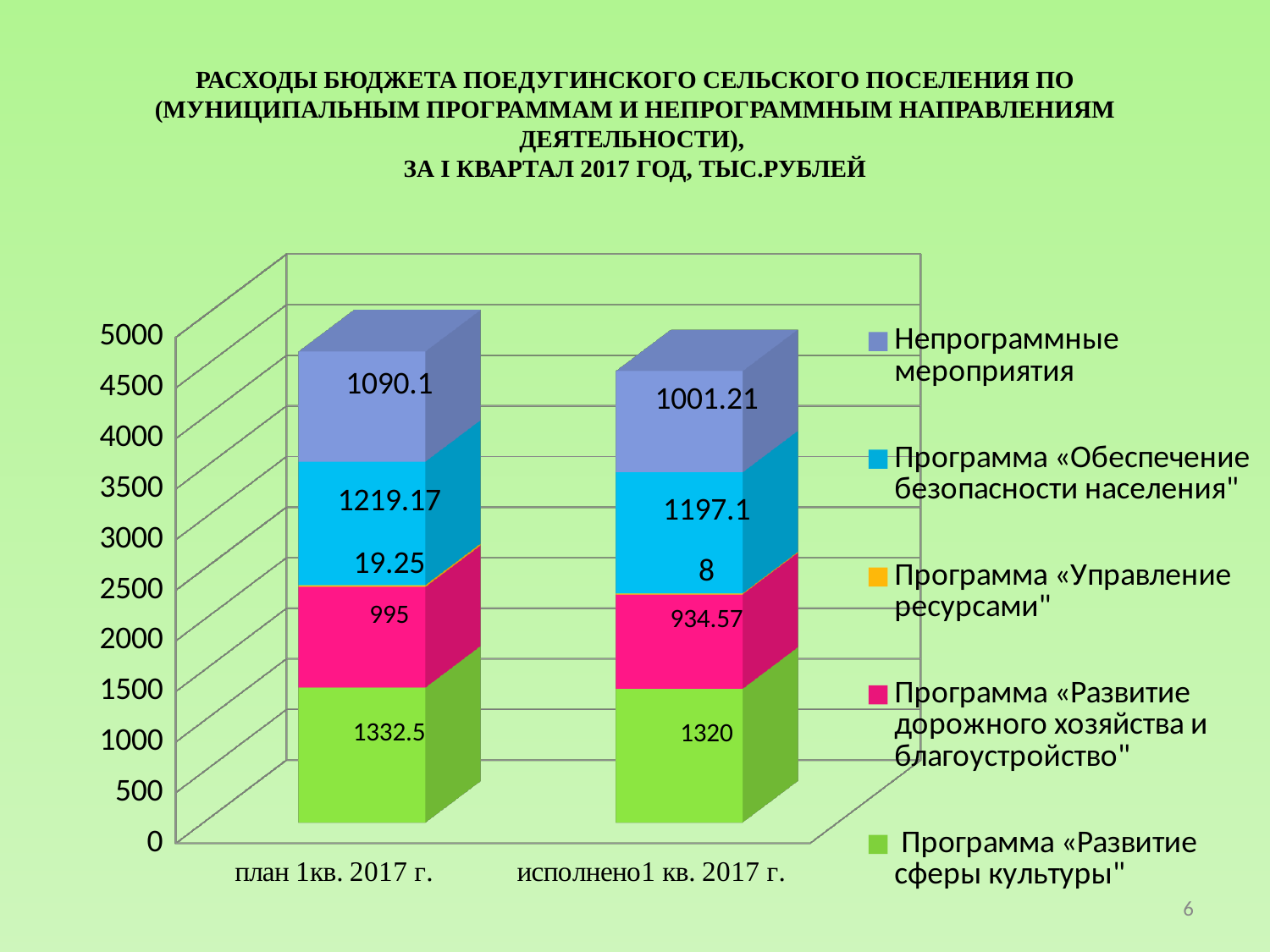
What is the value of «Программа «Управление ресурсами»» for план 1кв. 2017 г.? 19.25 What kind of chart is shown on the slide? Stacked bar chart What is the difference between the план and исполнено values for «Программа «Управление ресурсами»»? 11.25 What is the difference between the план and исполнено values for «Непрограммные мероприятия»? 88.89 How many series does the legend list? 5 What is the value of «Программа «Обеспечение безопасности населения»» for план 1кв. 2017 г.? 1219.17 What is the total of the stacked bar for план 1кв. 2017 г.? 4656.02 What is the value of «Программа «Развитие дорожного хозяйства и благоустройство»» for исполнено1 кв. 2017 г.? 934.57 What is the value of «Непрограммные мероприятия» for исполнено1 кв. 2017 г.? 1001.21 What is the total of the stacked bar for исполнено1 кв. 2017 г.? 4460.88 What is the value of «Программа «Развитие сферы культуры»» for план 1кв. 2017 г.? 1332.5 Which series has the smallest value in the исполнено1 кв. 2017 г. bar? Программа «Управление ресурсами»